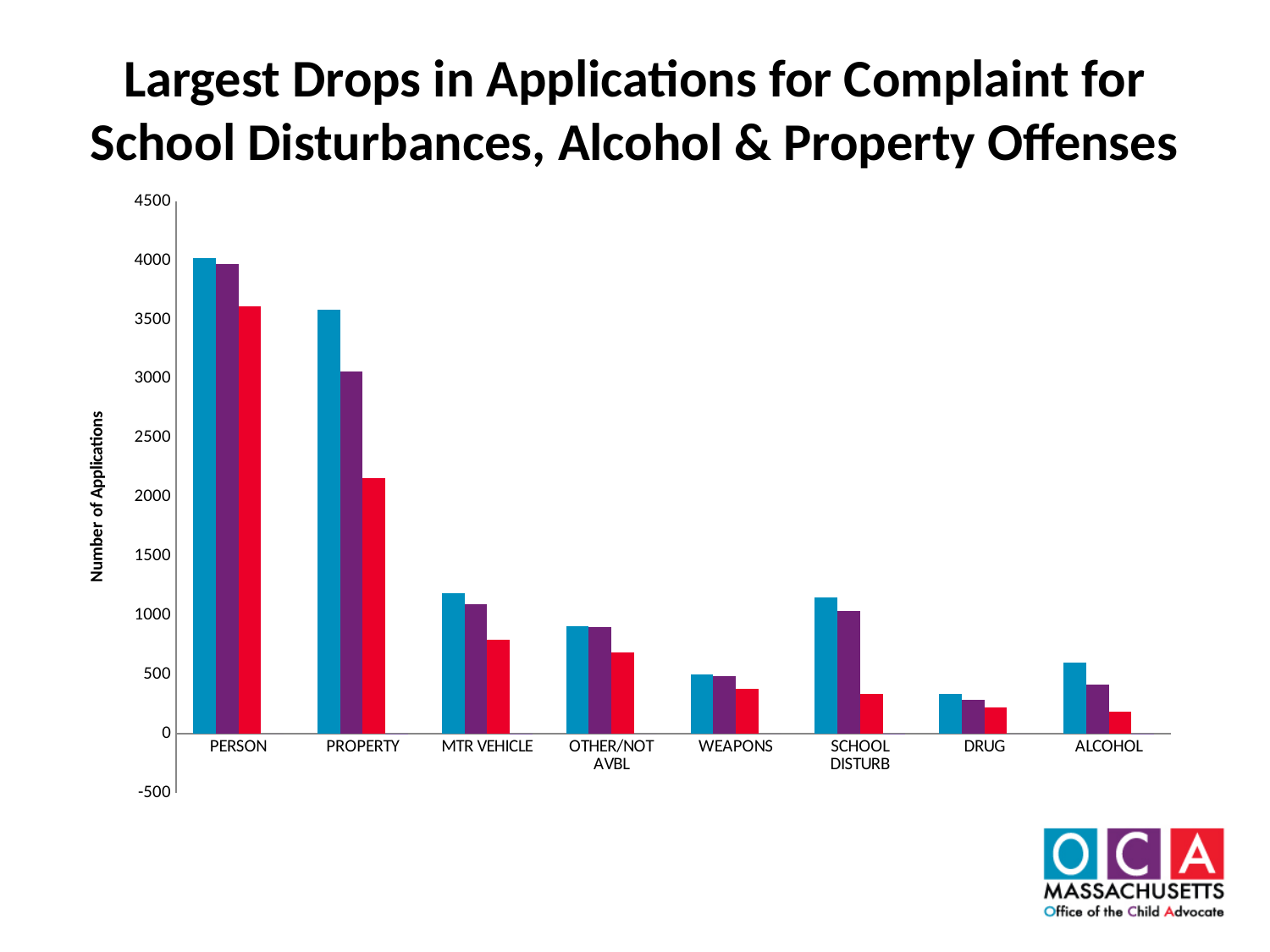
Which has the larger blue bar, PROPERTY or SCHOOL DISTURB? PROPERTY Is the value of the blue bar for MTR VEHICLE greater or less than 1000? greater How many offense categories are shown on the x axis? 8 Is the value of the blue bar for PERSON greater or less than 3500? greater Which category has the highest bars overall? PERSON What kind of chart is shown on the slide? bar chart Is the value of the blue bar for DRUG greater or less than 500? less What is the label on the vertical axis? Number of Applications Within the PROPERTY category, do the bars rise or fall from left to right? fall What is the title of the slide? Largest Drops in Applications for Complaint for School Disturbances, Alcohol & Property Offenses